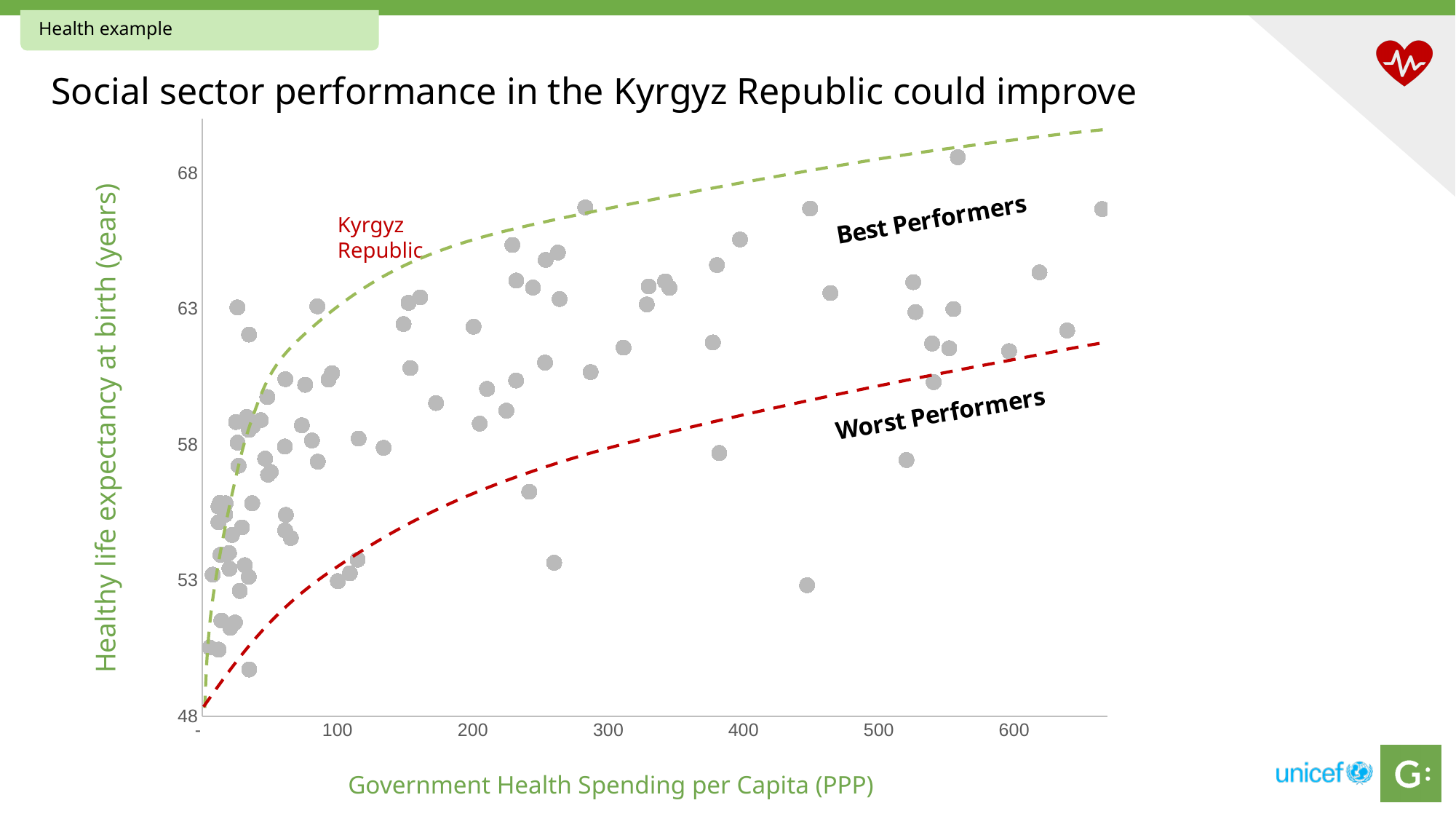
At a government health spending per capita of 200, is the 'Best Performers' line greater or less than 63 years? greater What is the label of the horizontal axis of the chart? Government Health Spending per Capita (PPP) What is the title of the chart on the slide? Social sector performance in the Kyrgyz Republic could improve Does the 'Best Performers' dashed line rise or fall as government health spending per capita increases? rise Does the 'Worst Performers' dashed line rise or fall as government health spending per capita increases? rise At a government health spending per capita of 600, is the 'Best Performers' line greater or less than 63 years? greater At a government health spending per capita of 300, which dashed line shows the higher healthy life expectancy, 'Best Performers' or 'Worst Performers'? Best Performers At a government health spending per capita of 100, is the 'Worst Performers' line greater or less than 58 years? less What kind of chart is shown on the slide? scatter chart